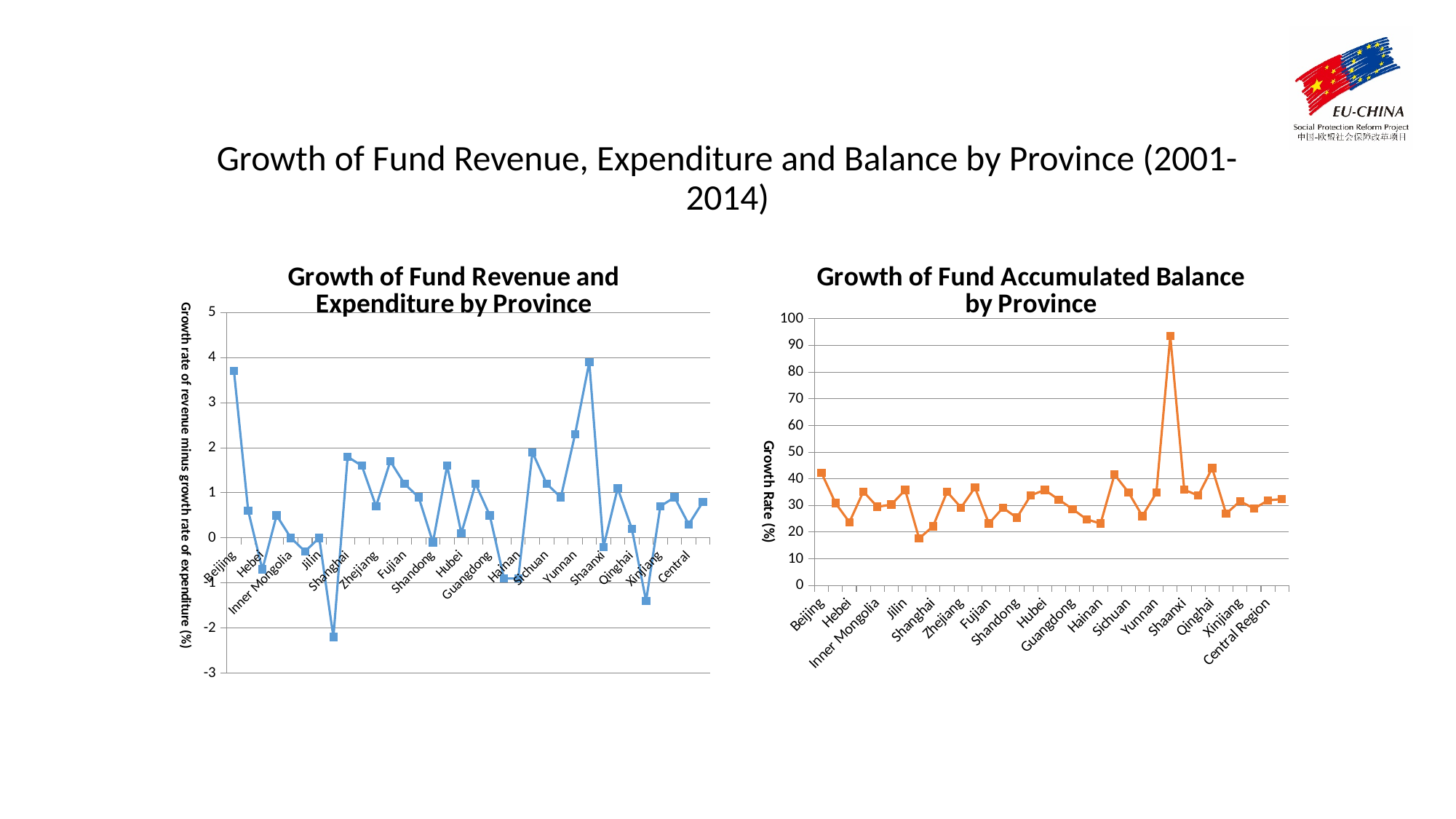
What kind of chart is the 'Growth of Fund Accumulated Balance by Province' chart? line chart In the 'Growth of Fund Revenue and Expenditure by Province' chart, which is larger, the value for Beijing or the value for Hebei? Beijing In the 'Growth of Fund Accumulated Balance by Province' chart, is the value for Shaanxi greater or less than 90? less In the 'Growth of Fund Revenue and Expenditure by Province' chart, is the value for Beijing greater or less than 3? greater In the 'Growth of Fund Accumulated Balance by Province' chart, is the value for Beijing greater or less than 30? greater In the 'Growth of Fund Accumulated Balance by Province' chart, which is larger, the value for Shaanxi or the value for Beijing? Beijing What is the y-axis title of the 'Growth of Fund Accumulated Balance by Province' chart? Growth Rate (%)